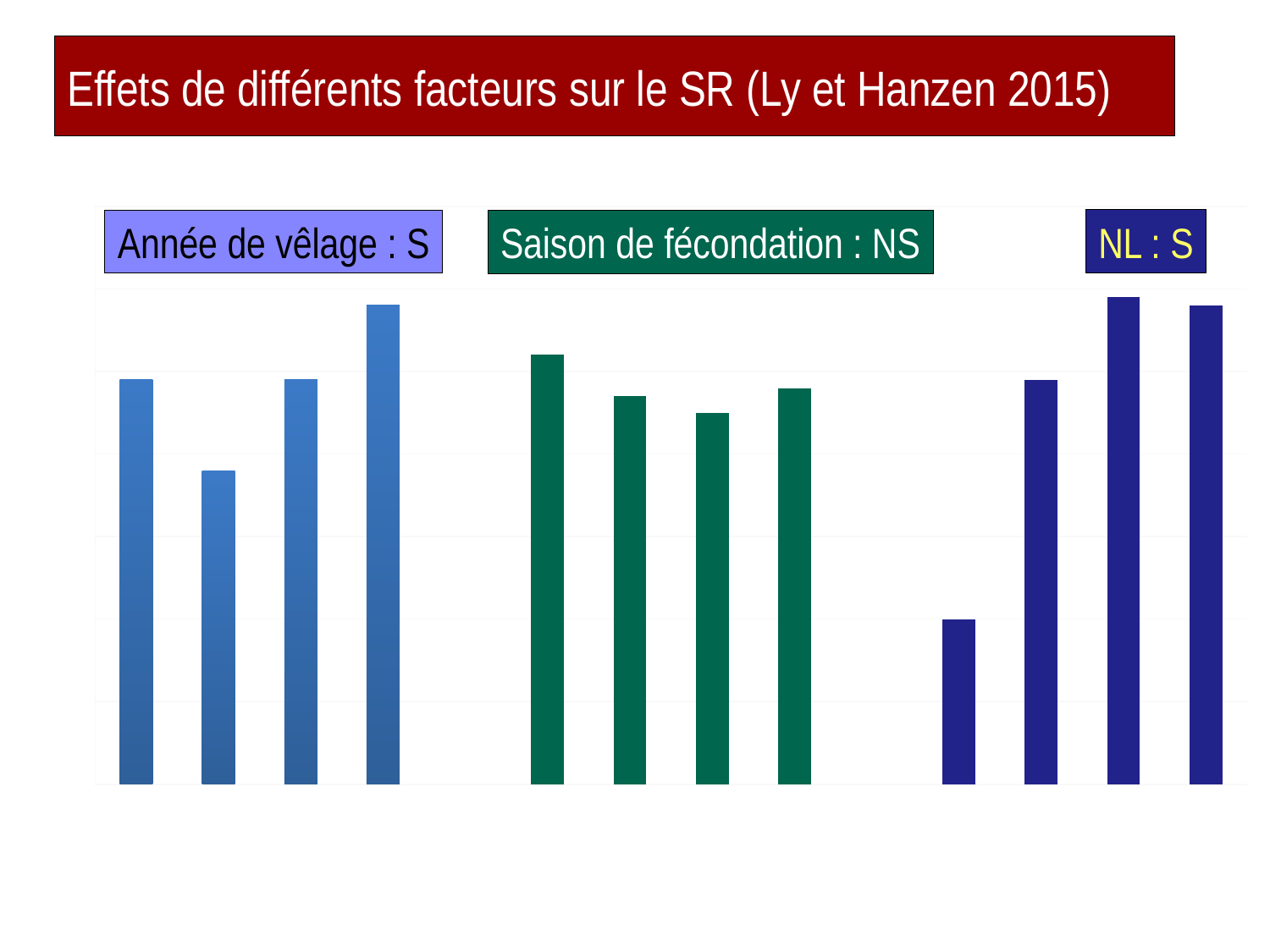
How many groups of bars does the chart show? 3 Within the "Saison de fécondation : NS" group, is the first bar taller or shorter than the third bar? taller How many bars are plotted in total on the chart? 12 What is the title of the slide? Effets de différents facteurs sur le SR (Ly et Hanzen 2015) What kind of chart is shown on the slide? bar chart How many bars are in the group labelled "Saison de fécondation : NS"? 4 Which group of bars contains the shortest bar on the chart? NL : S Within the "Année de vêlage : S" group, is the second bar taller or shorter than the first bar? shorter What colour are the bars in the "Saison de fécondation : NS" group? green Within the "NL : S" group, do the bars rise or fall from the first bar to the third bar? rise